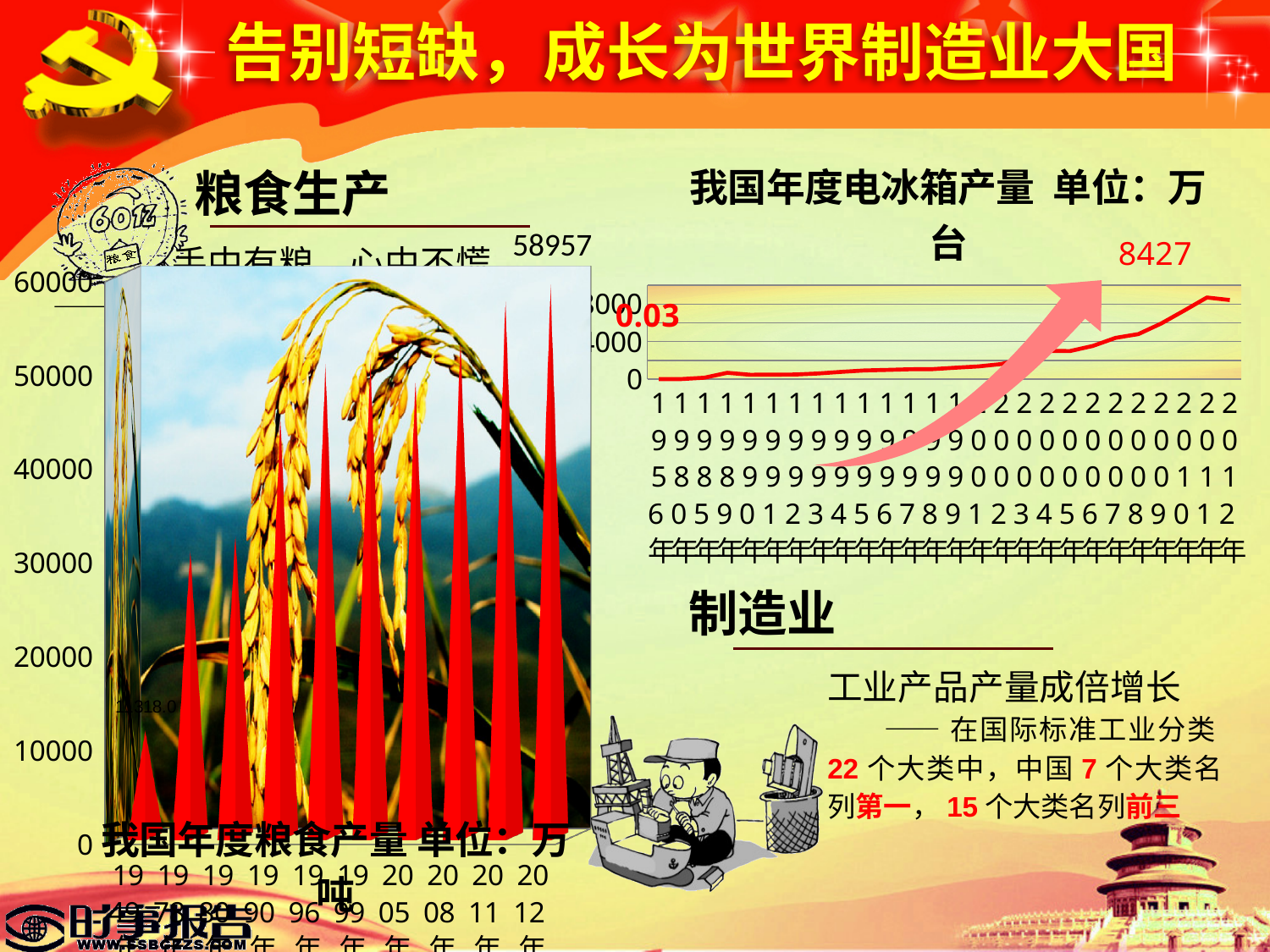
In the left chart (我国年度粮食产量), what is the value printed for the highest bar, 2012年? 58957 In the left chart (我国年度粮食产量), is the value for 2012年 greater or less than 50000? greater In the left chart (我国年度粮食产量), which year has the highest grain output? 2012年 What kind of chart is the right chart, 我国年度电冰箱产量? line chart In the left chart, what unit is given in the chart title 我国年度粮食产量? 万吨 In the right chart (我国年度电冰箱产量), what is the value printed at the start of the line? 0.03 What kind of chart is the left chart, 我国年度粮食产量? bar chart In the left chart (我国年度粮食产量), how many years are shown on the x axis? 10 In the right chart (我国年度电冰箱产量), do the values generally rise or fall over the years? rise In the left chart (我国年度粮食产量), is the value for 1949年 greater or less than 20000? less In the left chart (我国年度粮食产量), which year has the lowest grain output? 1949年 In the right chart (我国年度电冰箱产量), what is the highest value printed on the chart? 8427